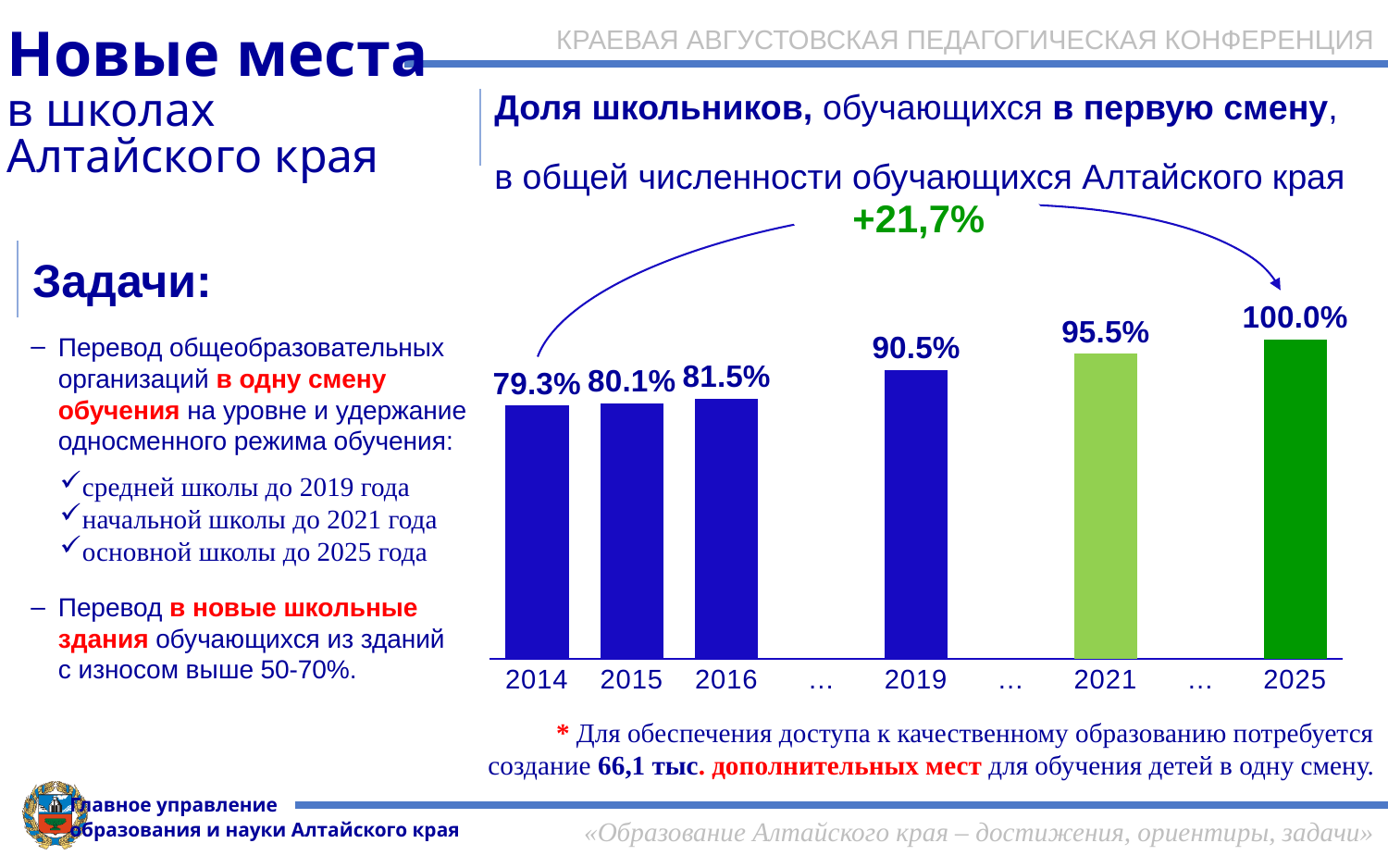
Which year has the lowest value on the chart? 2014 What kind of chart is shown on the slide? Bar chart What value is shown for 2019? 90.5% What is the difference between the values for 2025 and 2014? 20.7% Which is larger, the value for 2015 or the value for 2016? 2016 What value is shown for 2021? 95.5% What is the share of students studying in the first shift in 2014? 79.3% What value is shown for 2016? 81.5% What is the difference between the values for 2019 and 2016? 9.0% Which year has the highest value on the chart? 2025 Do the values rise or fall from 2014 to 2025? Rise How many bars are plotted on the chart? 6